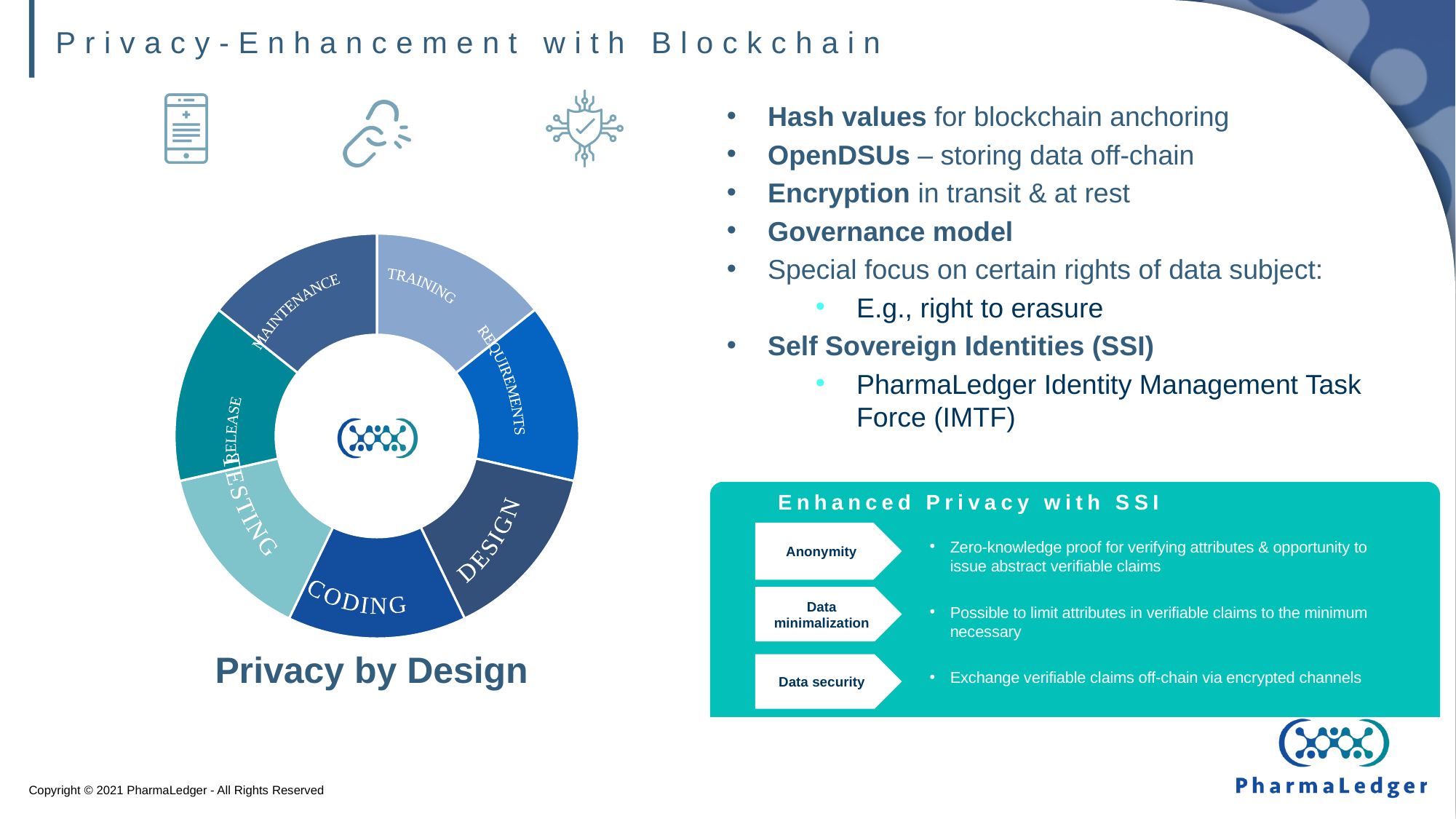
Which segment of the doughnut chart comes immediately before TRAINING going clockwise? MAINTENANCE What kind of chart is shown under the heading "Privacy by Design"? Doughnut chart What caption appears directly below the doughnut chart? Privacy by Design Which segment of the doughnut chart is labelled at the bottom, between TESTING and DESIGN? CODING Which segment of the doughnut chart is shown in the lightest teal colour, on the lower left? TESTING How many segments does the "Privacy by Design" doughnut chart have? 7 Which segment of the doughnut chart sits between TRAINING and DESIGN? REQUIREMENTS